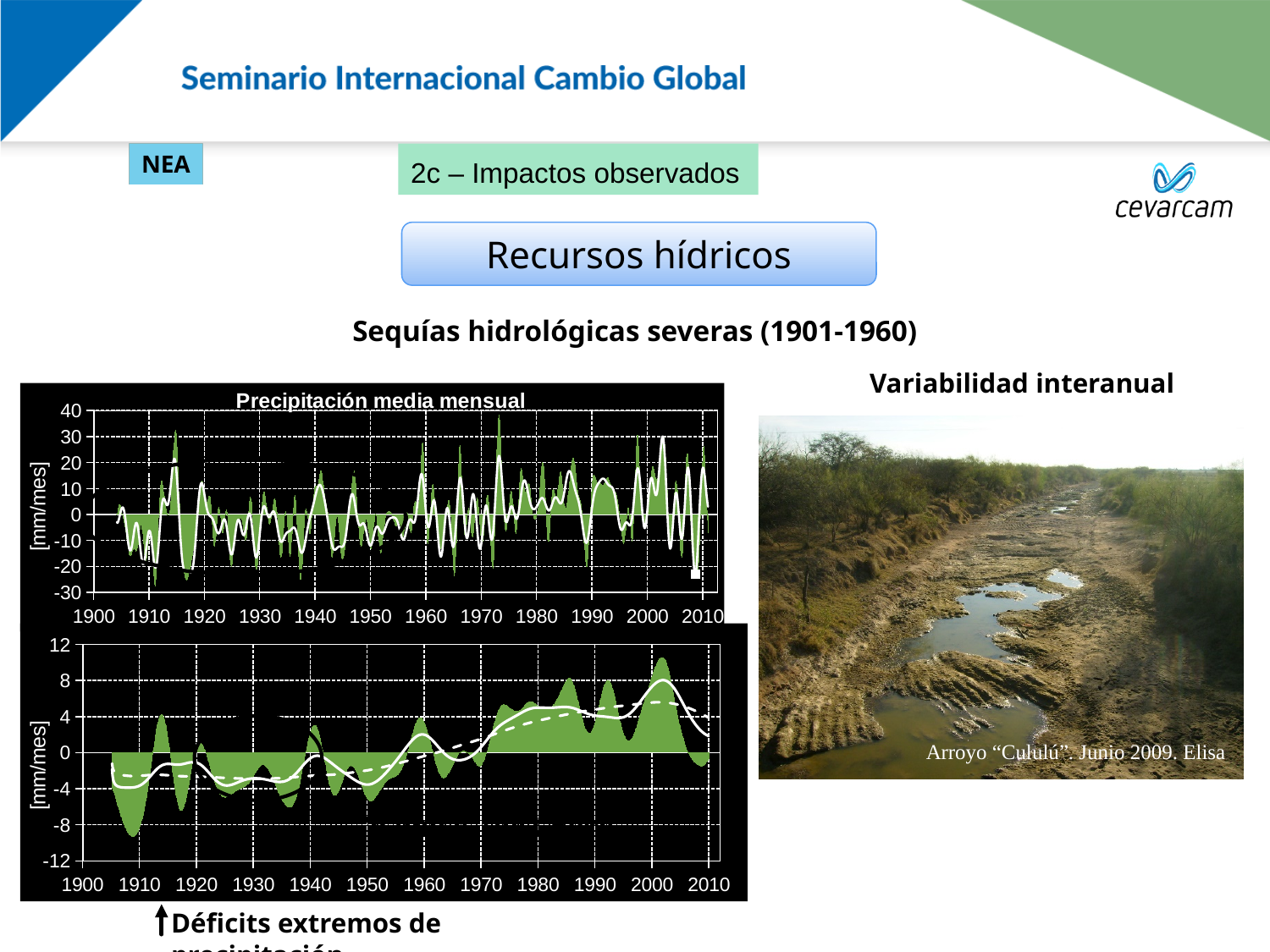
In the bottom chart, what is the highest value labelled on the y-axis? 12 In the top chart, 'Precipitación media mensual', is the lowest value around 1912 greater or less than -20? less In the top chart, 'Precipitación media mensual', is the peak value around 1973 greater or less than 30? greater What unit is shown on the y-axis of the top chart, 'Precipitación media mensual'? mm/mes How many year labels are shown on the x-axis of the bottom chart? 12 In the top chart, 'Precipitación media mensual', what is the first year labelled on the x-axis? 1900 In the bottom chart, which is larger: the value around 2000 or the value around 1910? around 2000 In the bottom chart, is the peak value around 2000 greater or less than 8? greater In the top chart, 'Precipitación media mensual', what is the last year labelled on the x-axis? 2010 What kind of chart is the top chart, 'Precipitación media mensual'? area chart What is the title of the top chart on the slide? Precipitación media mensual In the bottom chart, do the values generally rise or fall from 1900 to 2010? rise